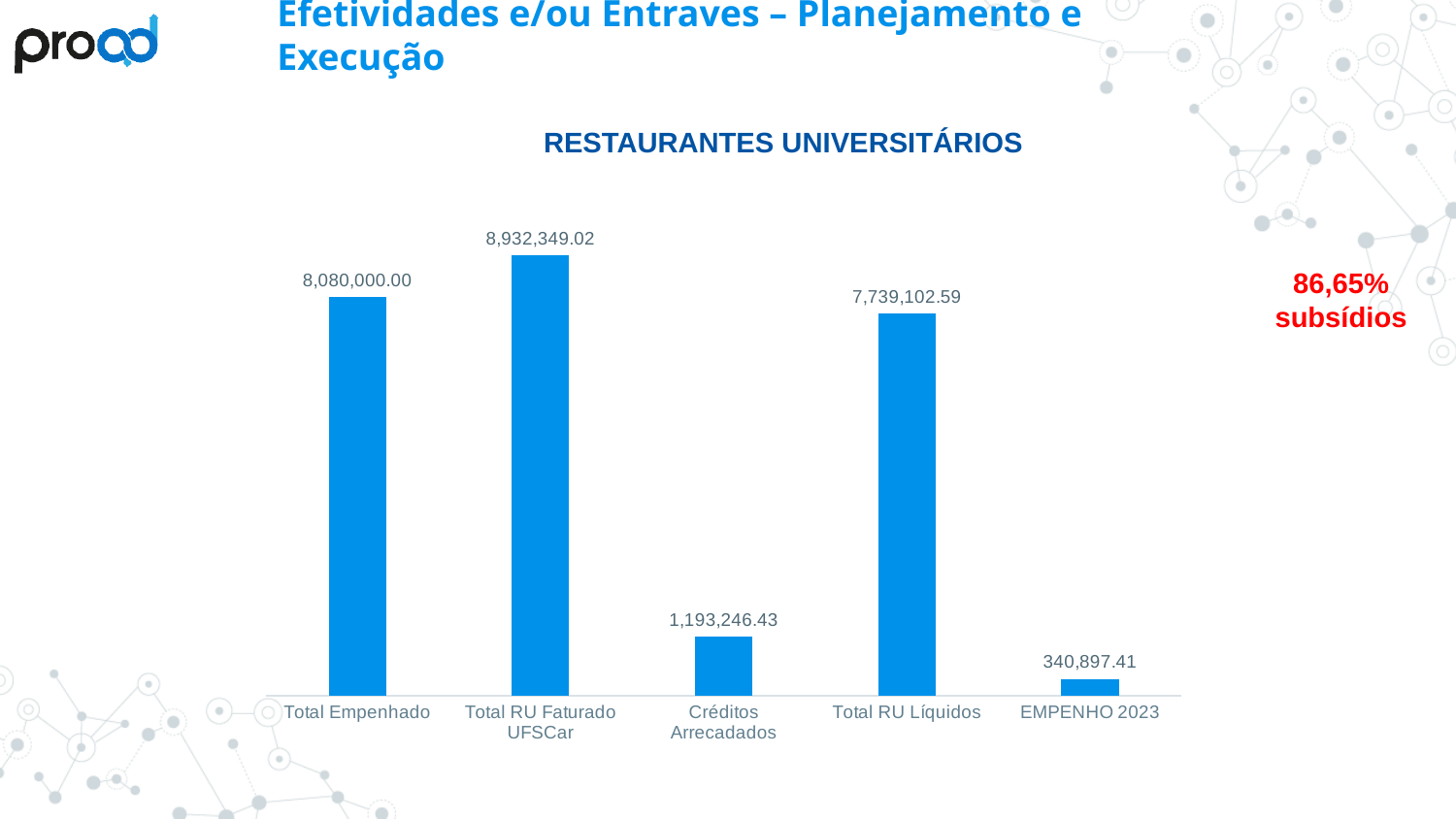
What is the value for Total RU Faturado UFSCar? 8,932,349.02 What is the value for EMPENHO 2023? 340,897.41 What is the value for Total Empenhado? 8,080,000.00 Which category has the highest value? Total RU Faturado UFSCar How many categories are shown in the chart? 5 Which category has the lowest value? EMPENHO 2023 What is the difference between Total Empenhado and EMPENHO 2023? 7,739,102.59 Which is larger, Total Empenhado or Total RU Líquidos? Total Empenhado What kind of chart is shown on the slide? Bar chart What is the value for Créditos Arrecadados? 1,193,246.43 What is the difference between Total RU Faturado UFSCar and Total RU Líquidos? 1,193,246.43 What is the title of the chart? RESTAURANTES UNIVERSITÁRIOS